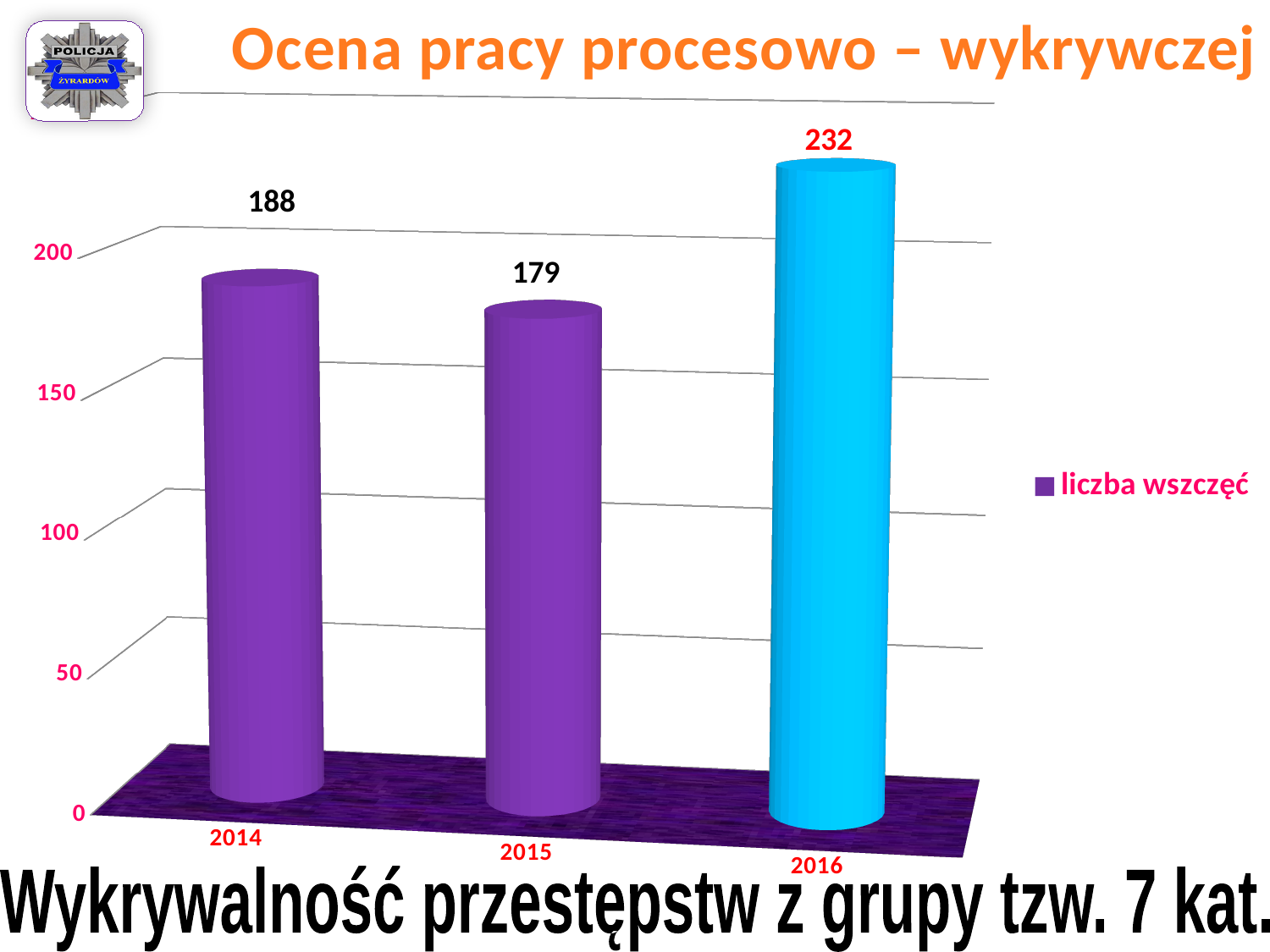
Which year has the highest value? 2016 What is the difference between the values for 2016 and 2014? 44 Which is larger, the value for 2014 or the value for 2015? 2014 What is the value for 2014? 188 How many years are shown on the chart? 3 What kind of chart is shown on the slide? bar chart What is the difference between the values for 2014 and 2015? 9 Is the value for 2016 greater or less than 200? greater What is the value for 2015? 179 What is the value for 2016? 232 Which year has the lowest value? 2015 What series name does the legend show? liczba wszczęć